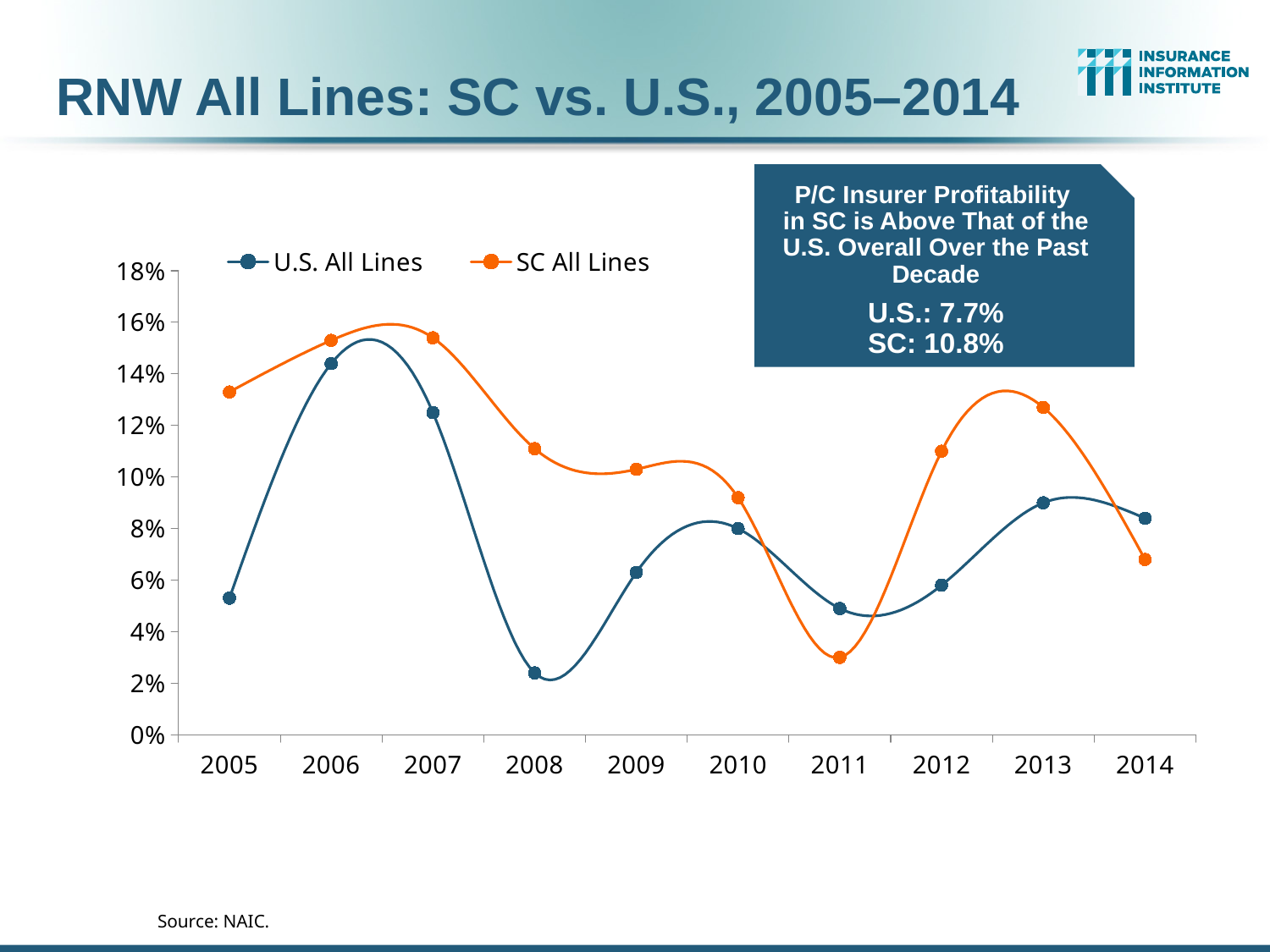
Is the U.S. All Lines value for 2008 greater or less than 4%? less According to the callout box, what is the decade average RNW for SC? 10.8% How many series does the legend list? 2 Is the SC All Lines value for 2013 greater or less than 12%? greater In 2011, which series has the larger value, U.S. All Lines or SC All Lines? U.S. All Lines In which year is the U.S. All Lines value highest? 2006 Is the SC All Lines value for 2006 greater or less than 14%? greater How many years are plotted along the x axis? 10 What kind of chart is shown on the slide? line chart Does the U.S. All Lines line rise or fall from 2011 to 2013? rise In which year is the U.S. All Lines value lowest? 2008 In which year is the SC All Lines value lowest? 2011